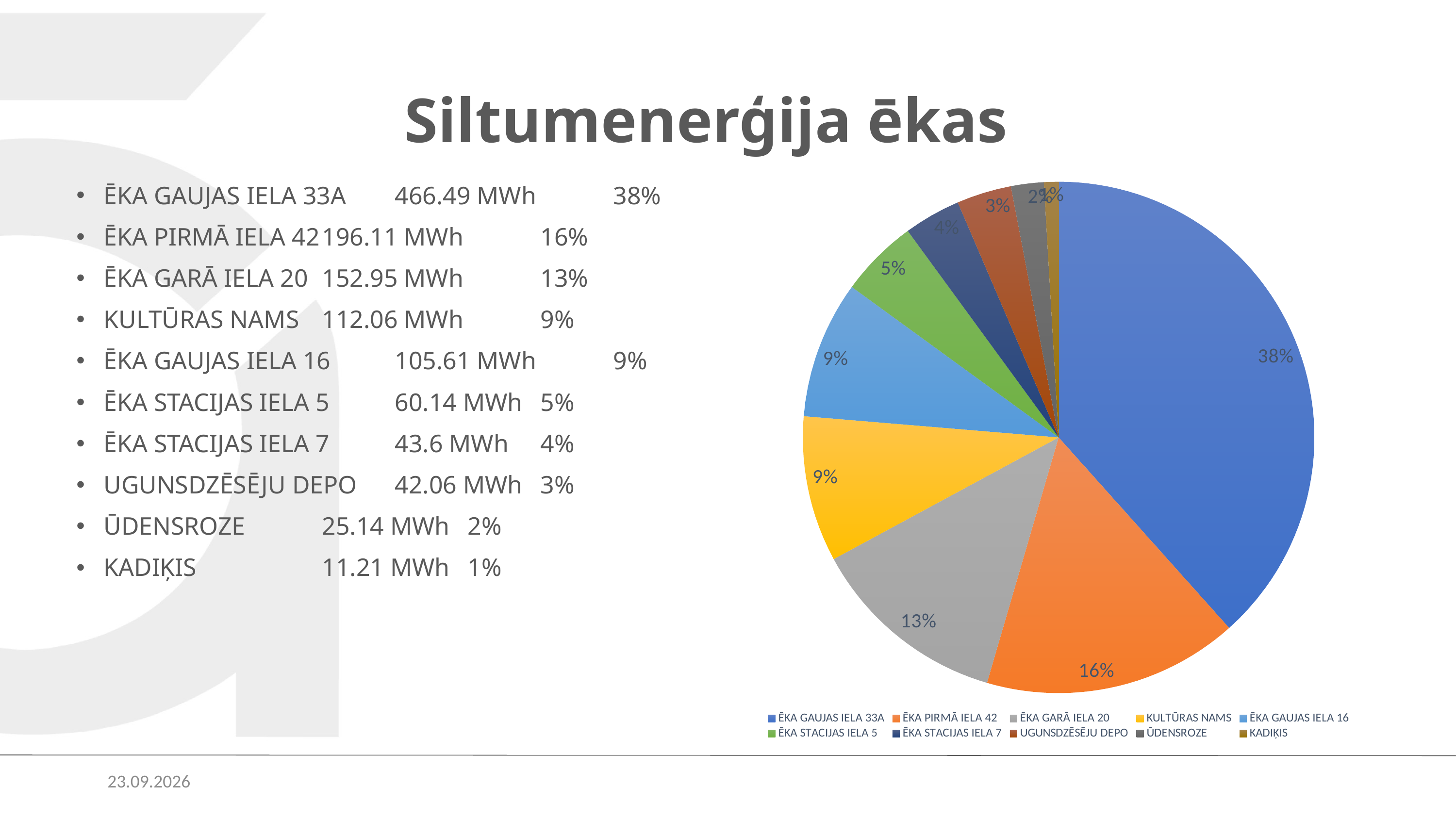
What share of the pie does ĒKA GARĀ IELA 20 have? 13% Which category has the smallest slice of the pie? KADIĶIS What share of the pie does ĒKA GAUJAS IELA 33A have? 38% What share of the pie does ĒKA STACIJAS IELA 5 have? 5% What is the difference in percentage points between the ĒKA GAUJAS IELA 33A slice and the ĒKA PIRMĀ IELA 42 slice? 22 Which slice is larger, ĒKA PIRMĀ IELA 42 or ĒKA GARĀ IELA 20? ĒKA PIRMĀ IELA 42 Which category has the largest slice of the pie? ĒKA GAUJAS IELA 33A How many categories does the pie chart's legend list? 10 What colour is the ĒKA GAUJAS IELA 33A slice in the pie chart? blue What kind of chart is shown on the slide? pie chart